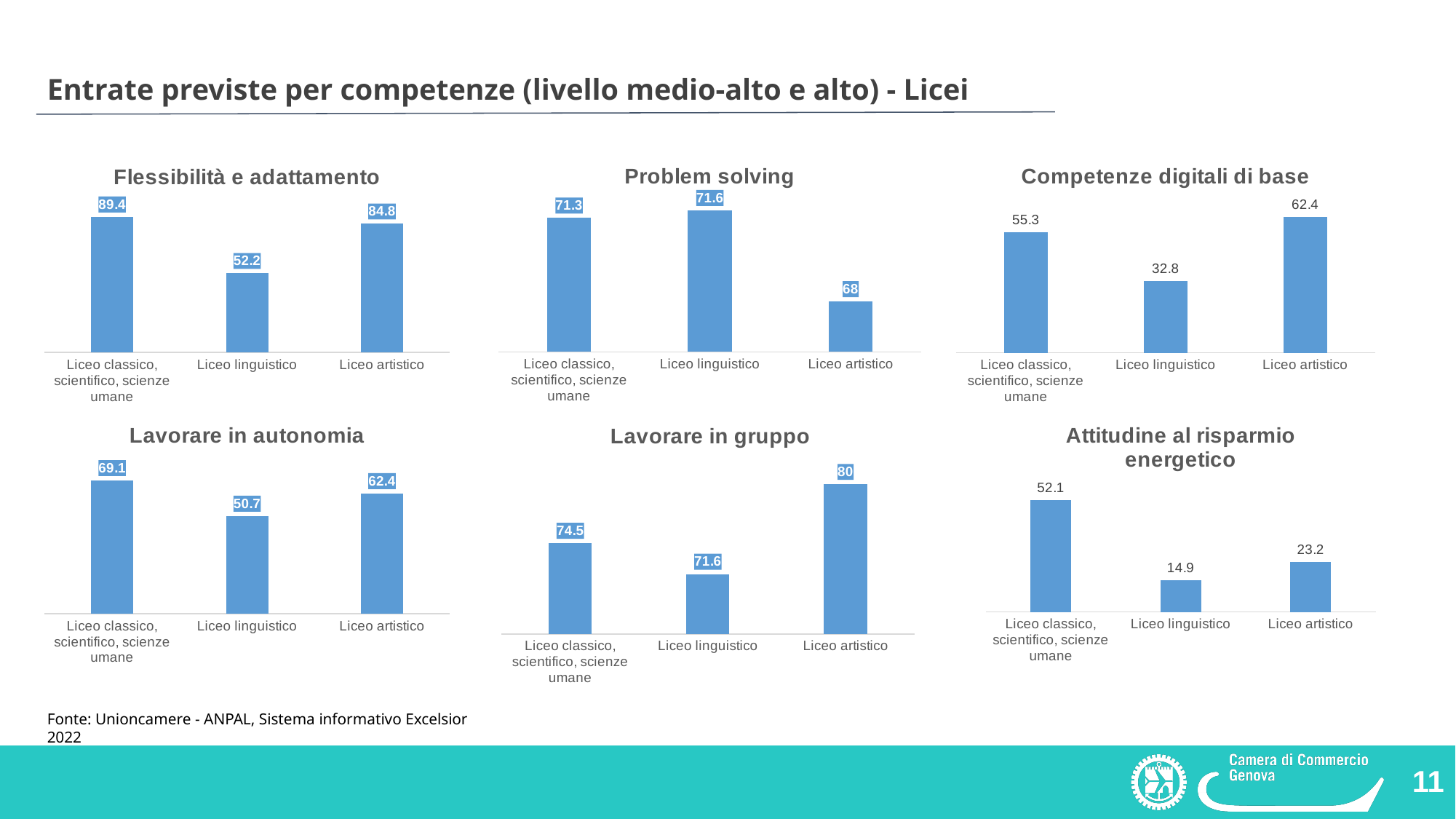
In the 'Attitudine al risparmio energetico' chart, which category has the highest value? Liceo classico, scientifico, scienze umane In the 'Flessibilità e adattamento' chart, what is the value for Liceo linguistico? 52.2 In the 'Problem solving' chart, which category has the lowest value? Liceo artistico How many charts are shown on the slide? 6 In the 'Flessibilità e adattamento' chart, which is larger: the value for Liceo classico, scientifico, scienze umane or the value for Liceo artistico? Liceo classico, scientifico, scienze umane How many categories are shown in the 'Problem solving' chart? 3 In the 'Competenze digitali di base' chart, what is the difference between the values for Liceo classico, scientifico, scienze umane and Liceo linguistico? 22.5 In the 'Lavorare in gruppo' chart, what is the difference between the values for Liceo artistico and Liceo linguistico? 8.4 What kind of chart is 'Lavorare in gruppo'? Bar chart In the 'Attitudine al risparmio energetico' chart, what is the value for Liceo linguistico? 14.9 In the 'Competenze digitali di base' chart, what is the value for Liceo artistico? 62.4 In the 'Lavorare in autonomia' chart, which category has the highest value? Liceo classico, scientifico, scienze umane